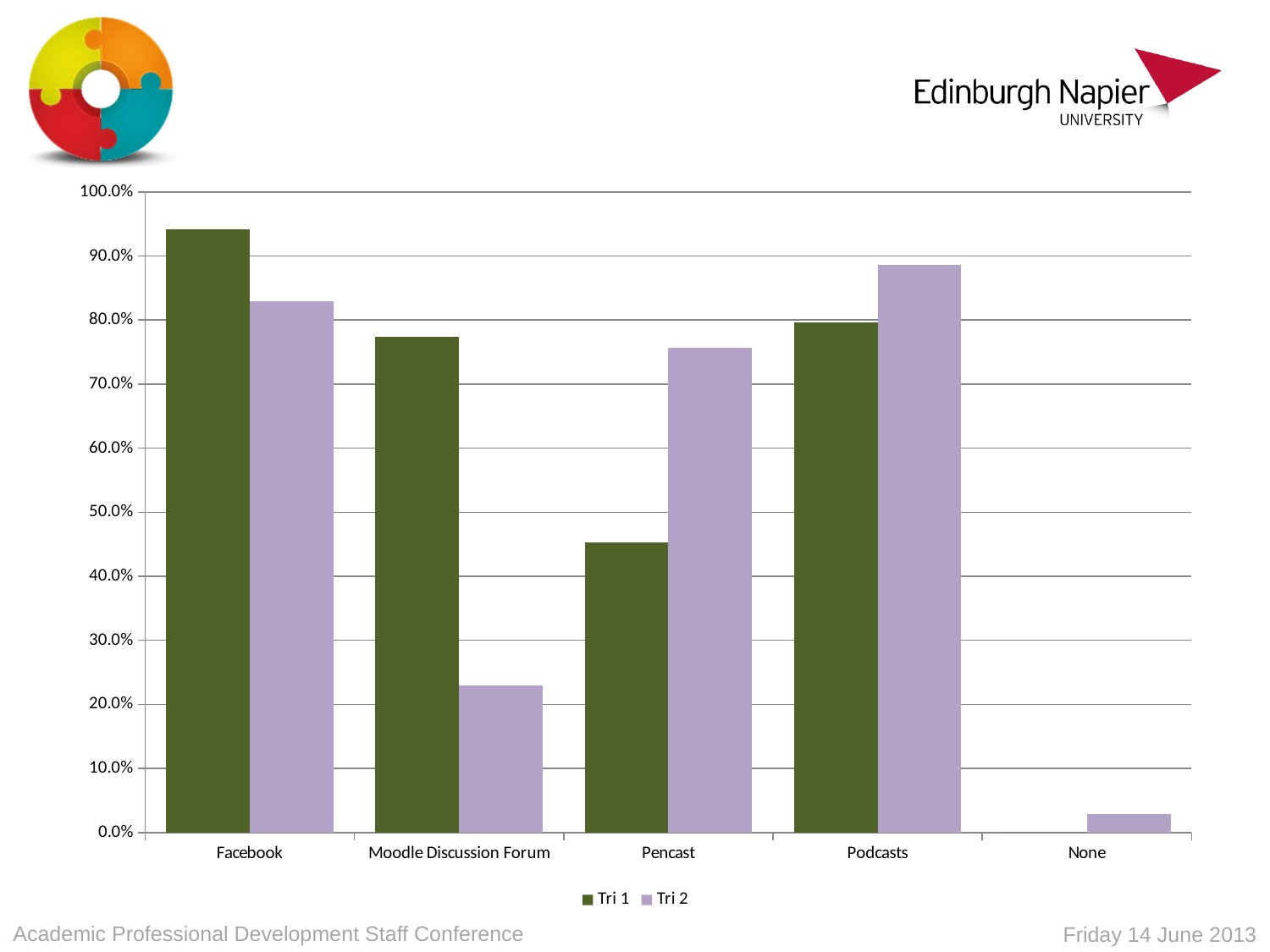
Which category has the highest Tri 2 value? Podcasts Which category has the highest Tri 1 value? Facebook How many categories are shown on the x axis? 5 For Moodle Discussion Forum, which series has the larger value, Tri 1 or Tri 2? Tri 1 Is the Tri 1 value for Pencast greater or less than 50.0%? less How many series does the legend list? 2 For Pencast, which series has the larger value, Tri 1 or Tri 2? Tri 2 Is the Tri 2 value for Moodle Discussion Forum greater or less than 30.0%? less Is the Tri 1 value for Facebook greater or less than 90.0%? greater What colour are the Tri 2 bars? purple Which category has the lowest Tri 2 value? None What kind of chart is shown on the slide? bar chart